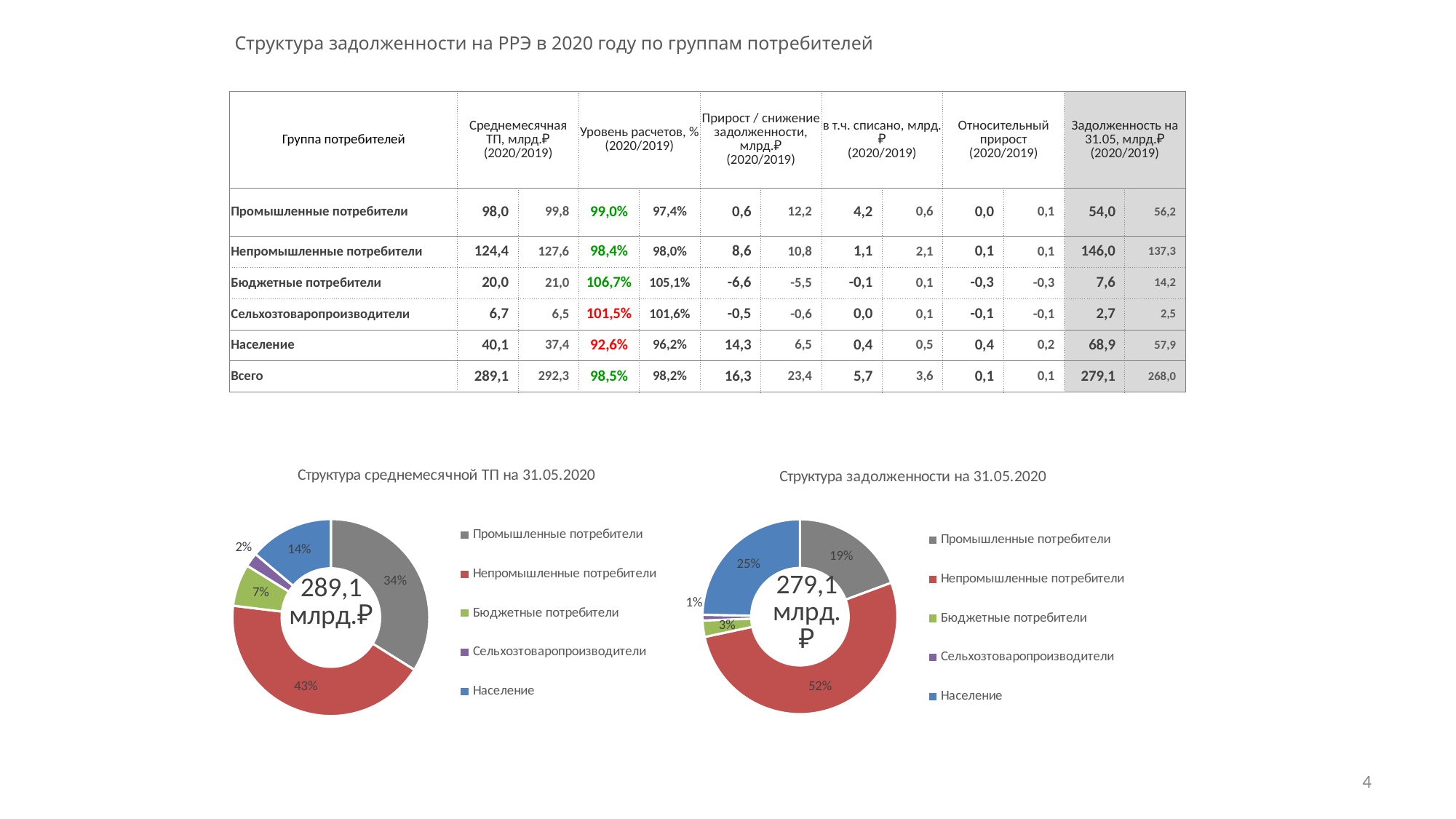
What total value is shown in the centre of the chart 'Структура задолженности на 31.05.2020'? 279,1 млрд.₽ In the chart 'Структура задолженности на 31.05.2020', which is larger: the share of Промышленные потребители or the share of Население? Население In the chart 'Структура среднемесячной ТП на 31.05.2020', what share does Непромышленные потребители have? 43% What kind of chart is 'Структура среднемесячной ТП на 31.05.2020'? Donut (pie) chart How many groups does the legend of the chart 'Структура задолженности на 31.05.2020' list? 5 In the chart 'Структура среднемесячной ТП на 31.05.2020', what is the share of Промышленные потребители? 34% In the chart 'Структура среднемесячной ТП на 31.05.2020', which colour represents Население? Blue In the chart 'Структура задолженности на 31.05.2020', what share does Население have? 25% In the chart 'Структура среднемесячной ТП на 31.05.2020', which group has the smallest share? Сельхозтоваропроизводители In the chart 'Структура среднемесячной ТП на 31.05.2020', what is the difference between the shares of Непромышленные потребители and Промышленные потребители? 9% In the chart 'Структура задолженности на 31.05.2020', which group has the largest share? Непромышленные потребители